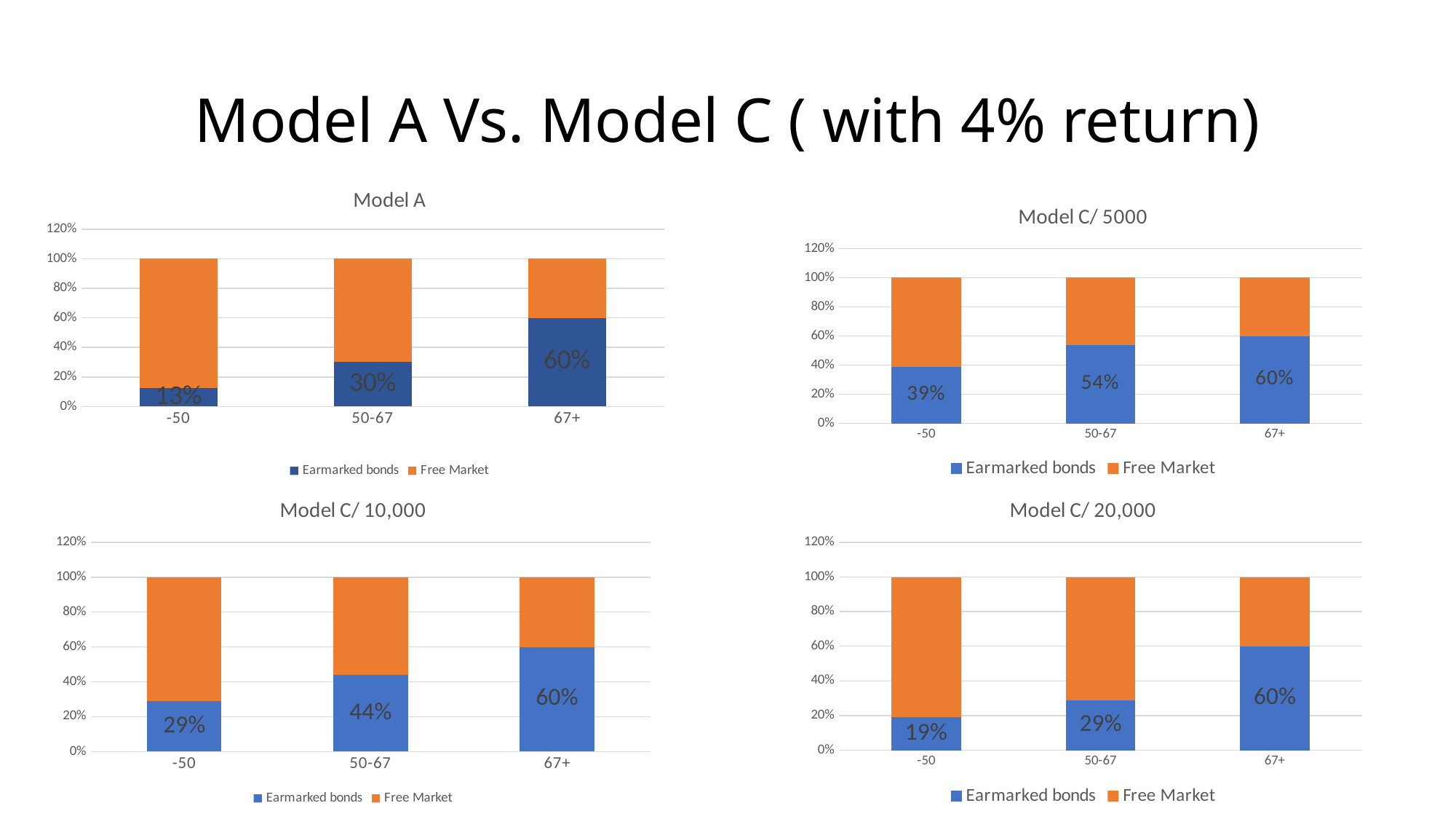
In the Model A chart, which category has the highest Earmarked bonds value? 67+ In the Model A chart, what is the Earmarked bonds value for the -50 category? 13% In the Model C/ 20,000 chart, what is the difference between the Earmarked bonds values for 67+ and -50? 41% In the Model A chart, do the Earmarked bonds values rise or fall from -50 to 67+? rise In the Model C/ 10,000 chart, which is larger: the Earmarked bonds value for 50-67 or for -50? 50-67 In the Model C/ 5000 chart, what is the Earmarked bonds value for the 50-67 category? 54% In the Model C/ 5000 chart, which category has the lowest Earmarked bonds value? -50 What kind of chart is the Model C/ 10,000 chart? stacked bar chart How many series does the legend of the Model C/ 5000 chart list? 2 In the Model C/ 20,000 chart, what is the Earmarked bonds value for the 50-67 category? 29% In the Model C/ 10,000 chart, what is the Earmarked bonds value for the -50 category? 29% In the Model C/ 20,000 chart, is the Free Market value for -50 greater or less than 60%? greater